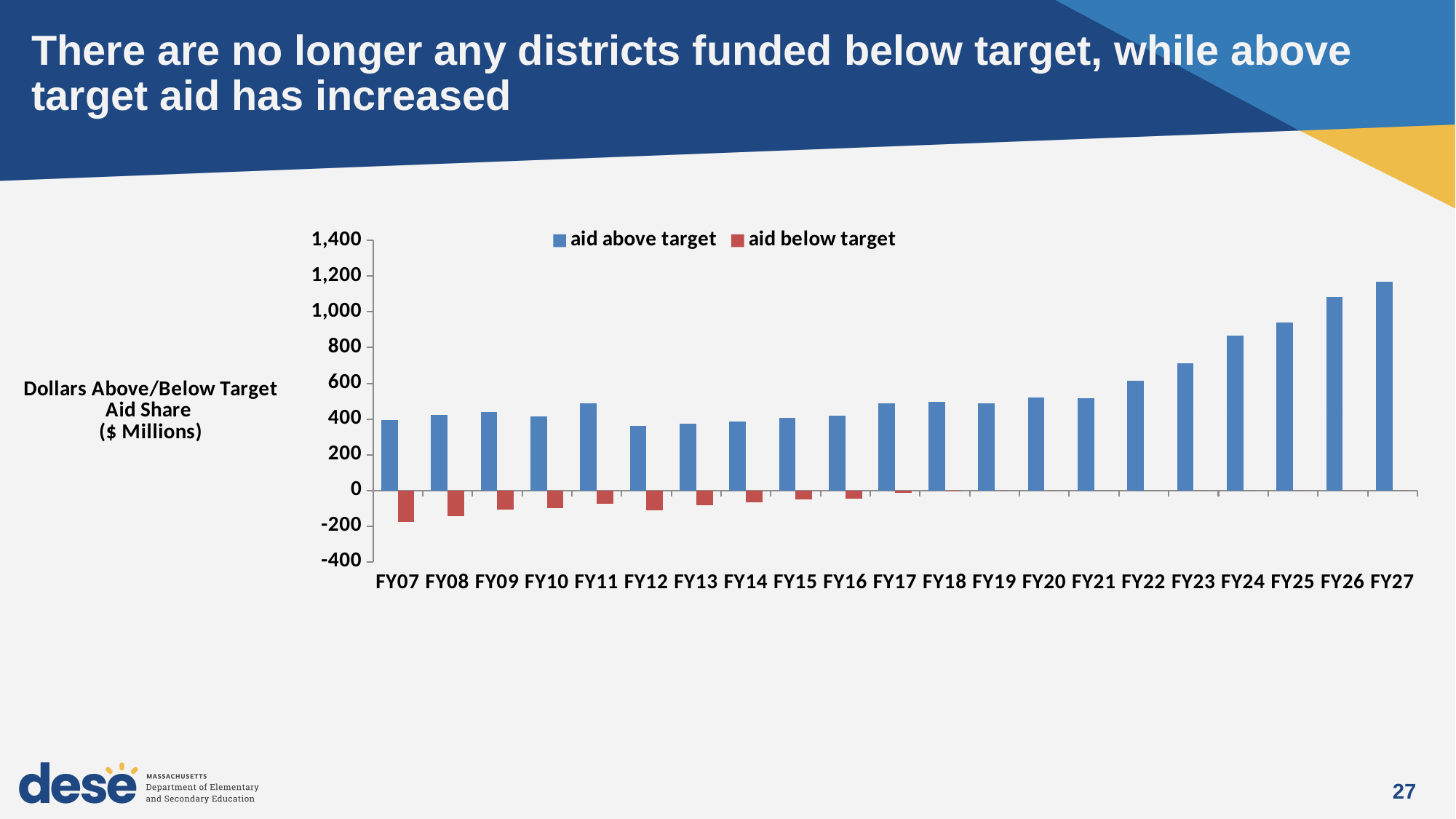
Does aid above target generally rise or fall from FY07 to FY27? rise How many fiscal years are shown on the x axis? 21 Is the aid above target for FY23 greater or less than 600? greater What kind of chart is shown on the slide? bar chart What colour are the aid below target bars? red Is the aid above target for FY27 greater or less than 1,000? greater Is the aid above target for FY12 greater or less than 400? less How many series does the legend list? 2 Which has the larger aid above target, FY11 or FY12? FY11 Which fiscal year has the highest aid above target? FY27 Which fiscal year has the largest (most negative) aid below target? FY07